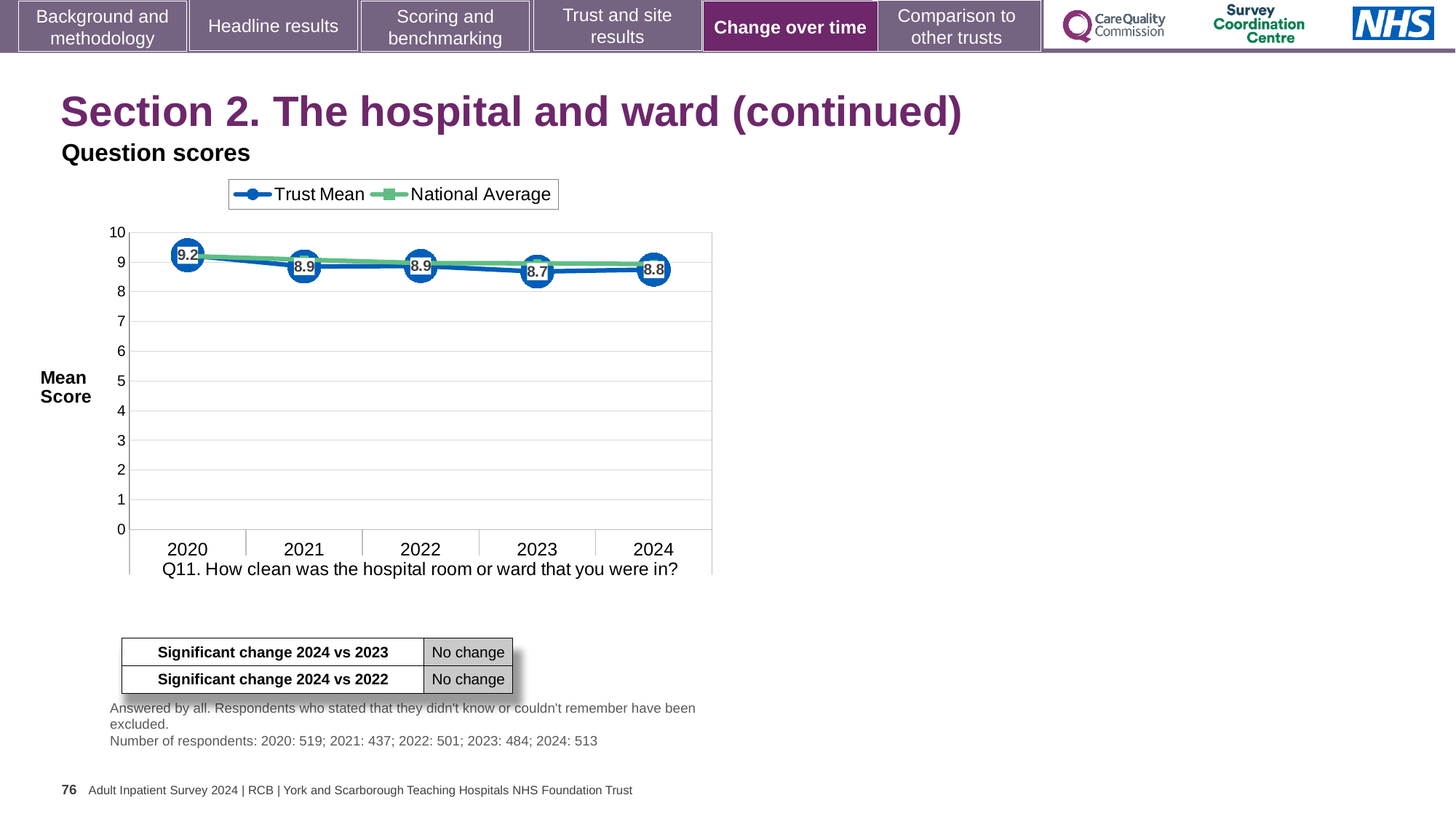
Is the National Average value for 2024 greater or less than 8? greater How many series does the chart legend list? 2 Does the Trust Mean score rise or fall from 2020 to 2023? Fall In which year is the Trust Mean score lowest? 2023 What kind of chart is shown on the slide? Line chart Which is larger, the Trust Mean score in 2020 or in 2024? 2020 What is the Trust Mean score for 2023? 8.7 What is the Trust Mean score for 2020? 9.2 How many years are shown on the x axis of the chart? 5 What is the Trust Mean score for 2024? 8.8 In which year is the Trust Mean score highest? 2020 What is the difference between the Trust Mean score in 2020 and in 2023? 0.5